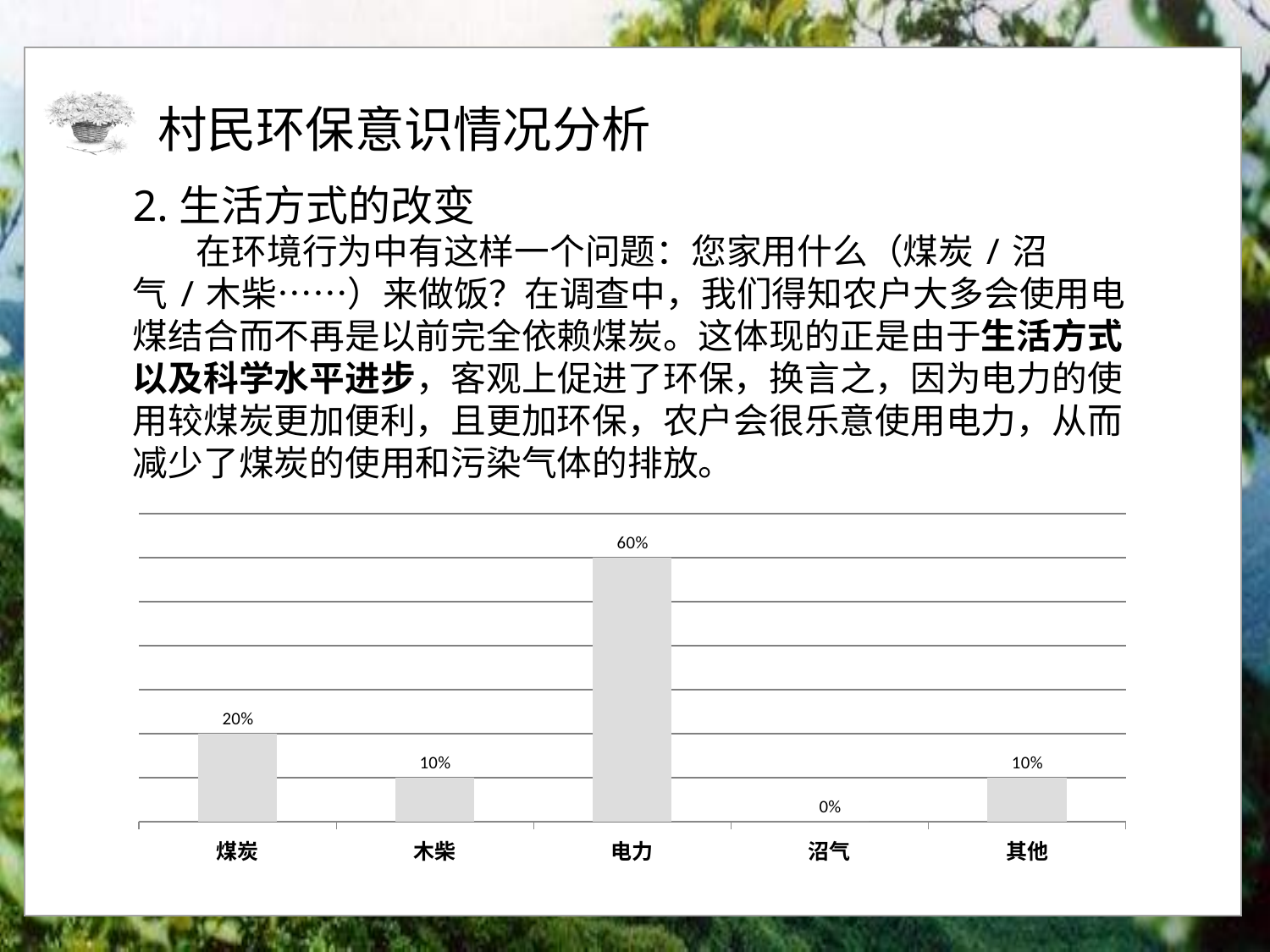
What kind of chart is shown on the slide? bar chart What is the difference between the values for 电力 and 煤炭? 40% What is the value for 煤炭 in the chart? 20% What colour are the bars in the chart? grey Which category has the highest value in the chart? 电力 What is the difference between the values for 煤炭 and 木柴? 10% How many categories are shown on the x axis of the chart? 5 Which category has the lowest value in the chart? 沼气 What is the value for 木柴 in the chart? 10% What is the value for 电力 in the chart? 60% What is the value for 沼气 in the chart? 0% Which is larger, the value for 煤炭 or the value for 其他? 煤炭